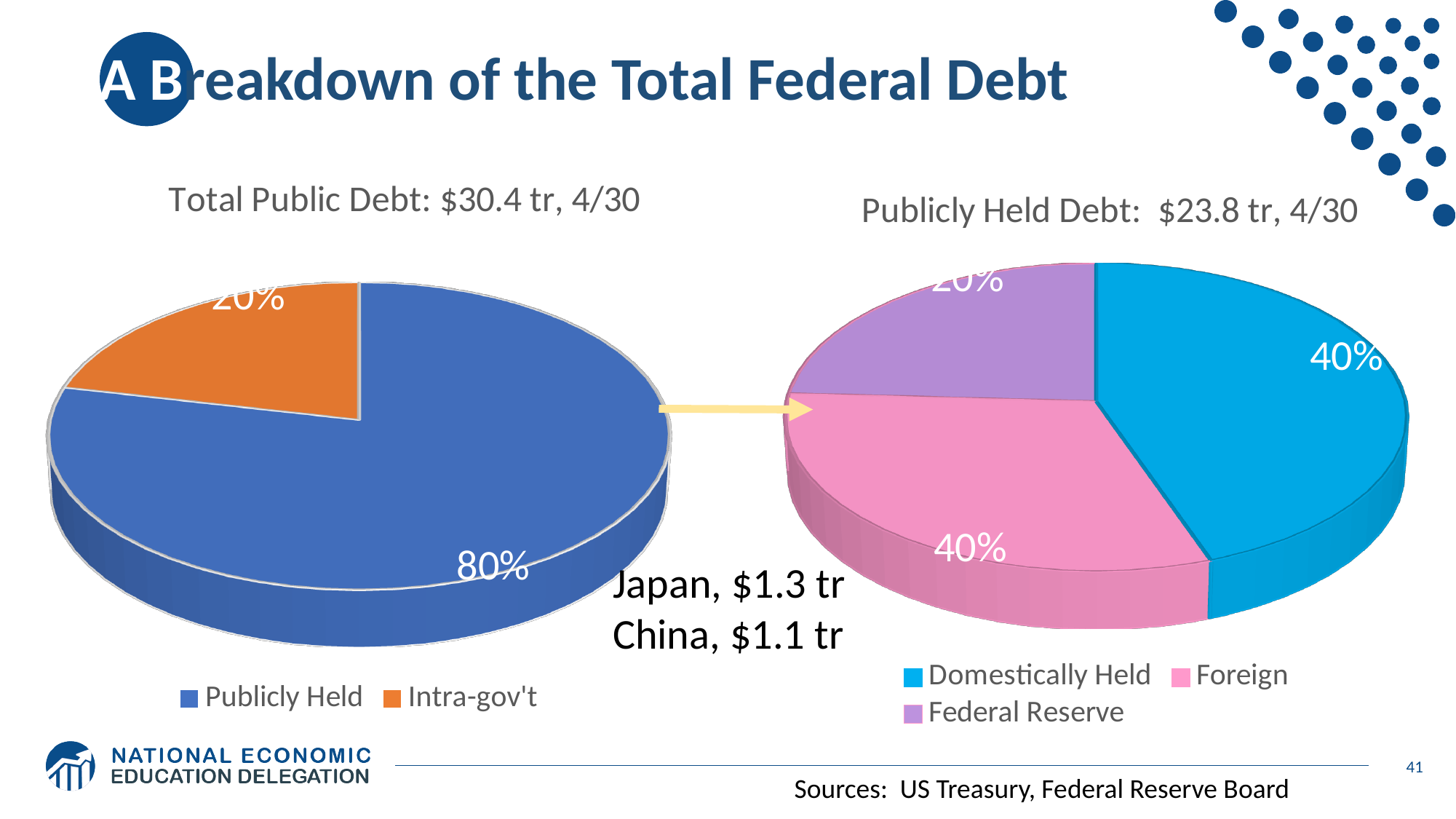
How many entries does the legend of the "Publicly Held Debt" chart list? 3 In the "Publicly Held Debt" chart, what is the difference in percentage points between the Domestically Held and Federal Reserve slices? 20 percentage points In the "Publicly Held Debt" chart, what share of the pie is Federal Reserve? 20% In the "Publicly Held Debt" chart, what share of the pie is Foreign? 40% In the "Publicly Held Debt" chart, which slice is the smallest? Federal Reserve In the "Total Public Debt" chart, what share of the pie is Publicly Held? 80% In the "Total Public Debt" chart, which slice is the largest? Publicly Held What kind of chart is the "Total Public Debt" chart on the left? pie chart How many slices does the "Total Public Debt" chart have? 2 In the "Total Public Debt" chart, which is larger: Intra-gov't or Publicly Held? Publicly Held What total amount is stated in the title of the "Publicly Held Debt" chart? $23.8 tr